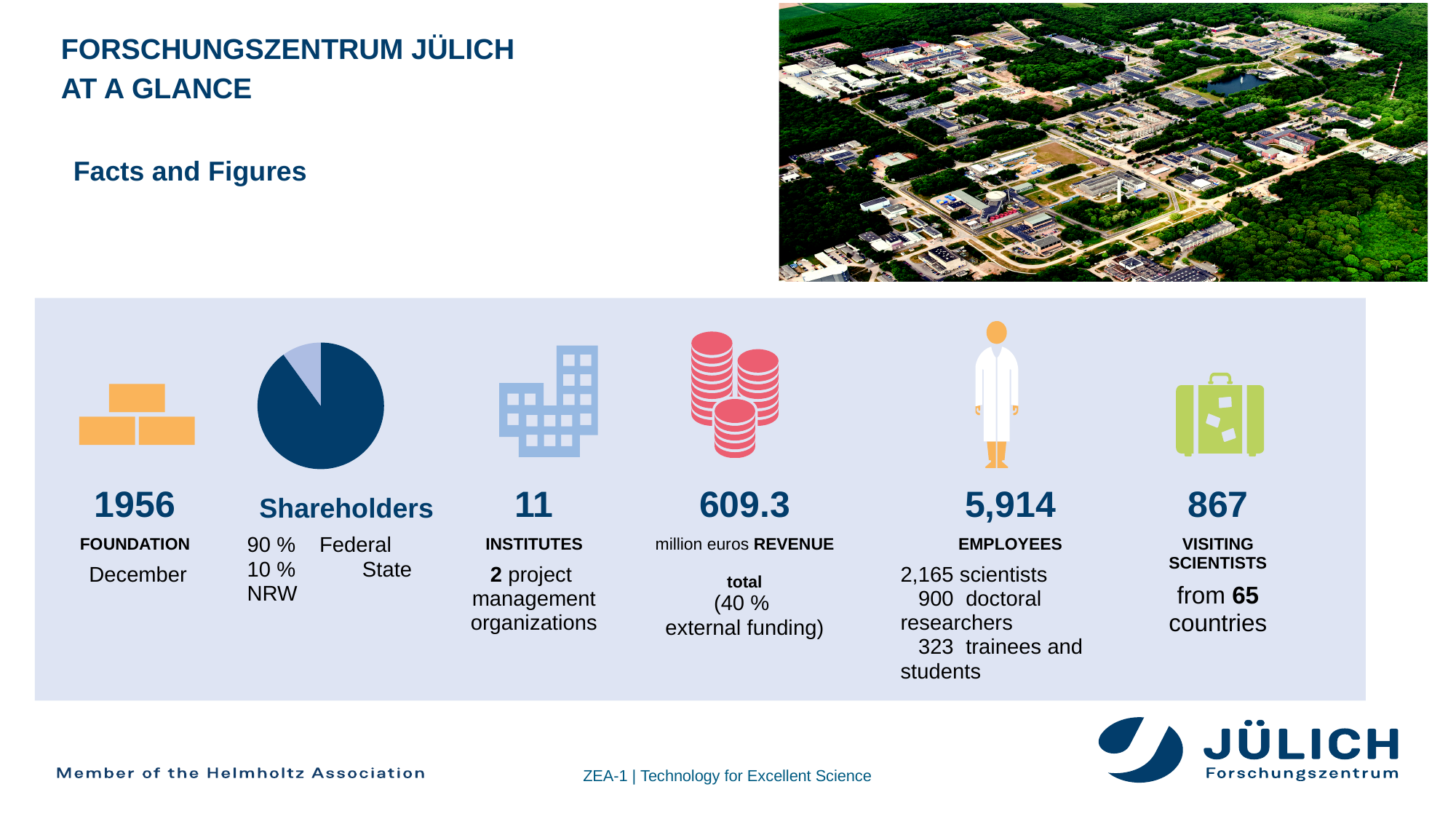
In the Shareholders pie chart, what do the two slices add up to? 100 % What kind of chart is the Shareholders chart? pie chart In the Shareholders pie chart, which shareholder has the smallest slice? NRW What is the title of the pie chart on the slide? Shareholders In the Shareholders pie chart, which is larger: the Federal State share or the NRW share? Federal State In the Shareholders pie chart, what share is held by NRW? 10 % In the Shareholders pie chart, what share of the pie does the NRW slice represent? 10 % In the Shareholders pie chart, what is the difference between the Federal State share and the NRW share? 80 % In the Shareholders pie chart, which shareholder has the largest slice? Federal State In the Shareholders pie chart, what share is held by the Federal State? 90 % In the Shareholders pie chart, what colour is the Federal State slice? dark blue How many slices does the Shareholders pie chart have? 2